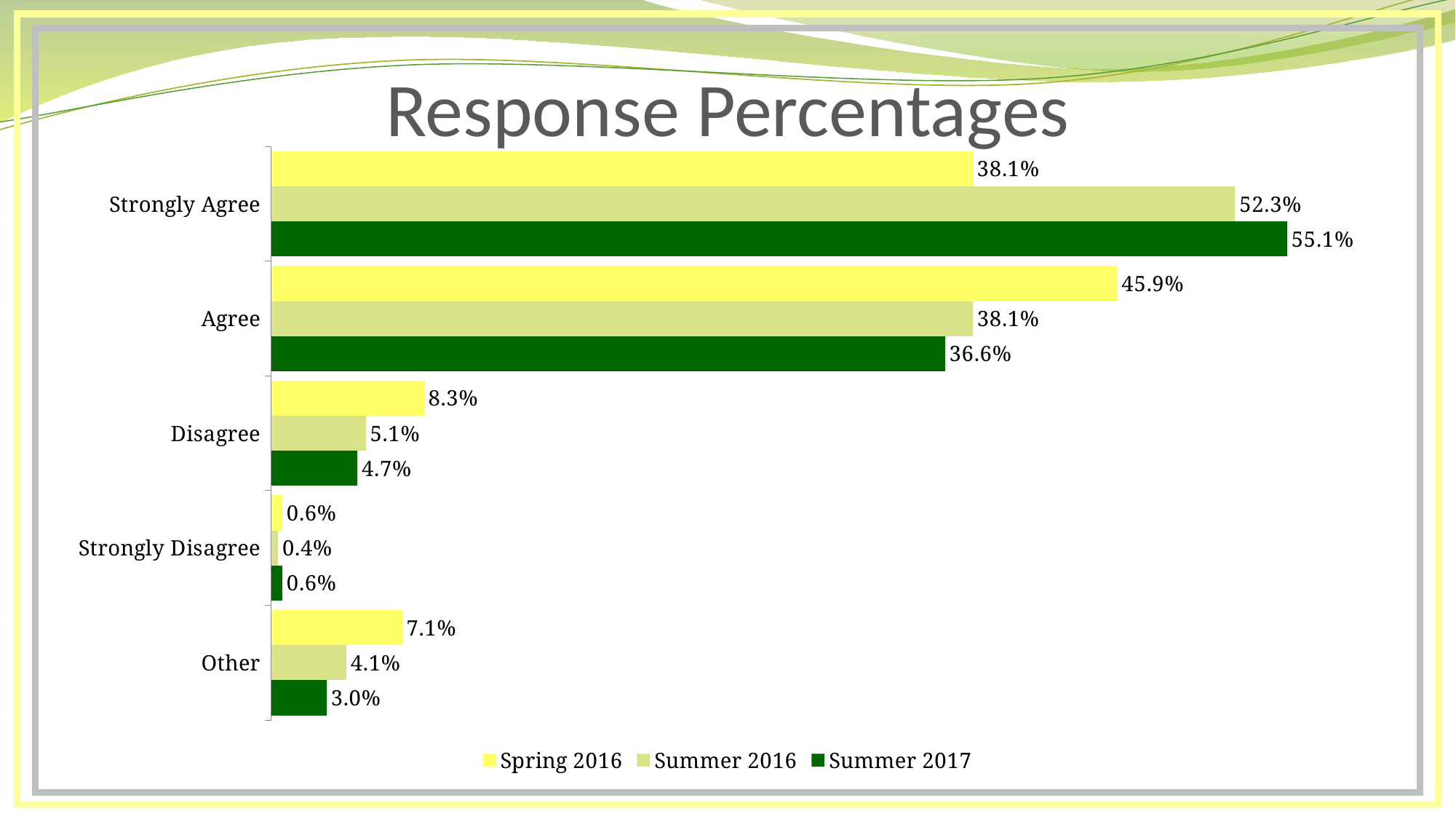
How many series does the legend list? 3 Which category has the lowest Spring 2016 value? Strongly Disagree Which category has the highest Summer 2017 value? Strongly Agree What is the Summer 2017 value for Strongly Agree? 55.1% What is the title of the chart? Response Percentages Which series is shown in dark green? Summer 2017 What is the Spring 2016 value for Agree? 45.9% What kind of chart is shown on the slide? Bar chart What is the difference between the Summer 2016 and Spring 2016 values for Strongly Agree? 14.2% What is the Summer 2016 value for Other? 4.1% Which is larger for Agree: the Spring 2016 value or the Summer 2017 value? Spring 2016 How many response categories are shown on the chart? 5